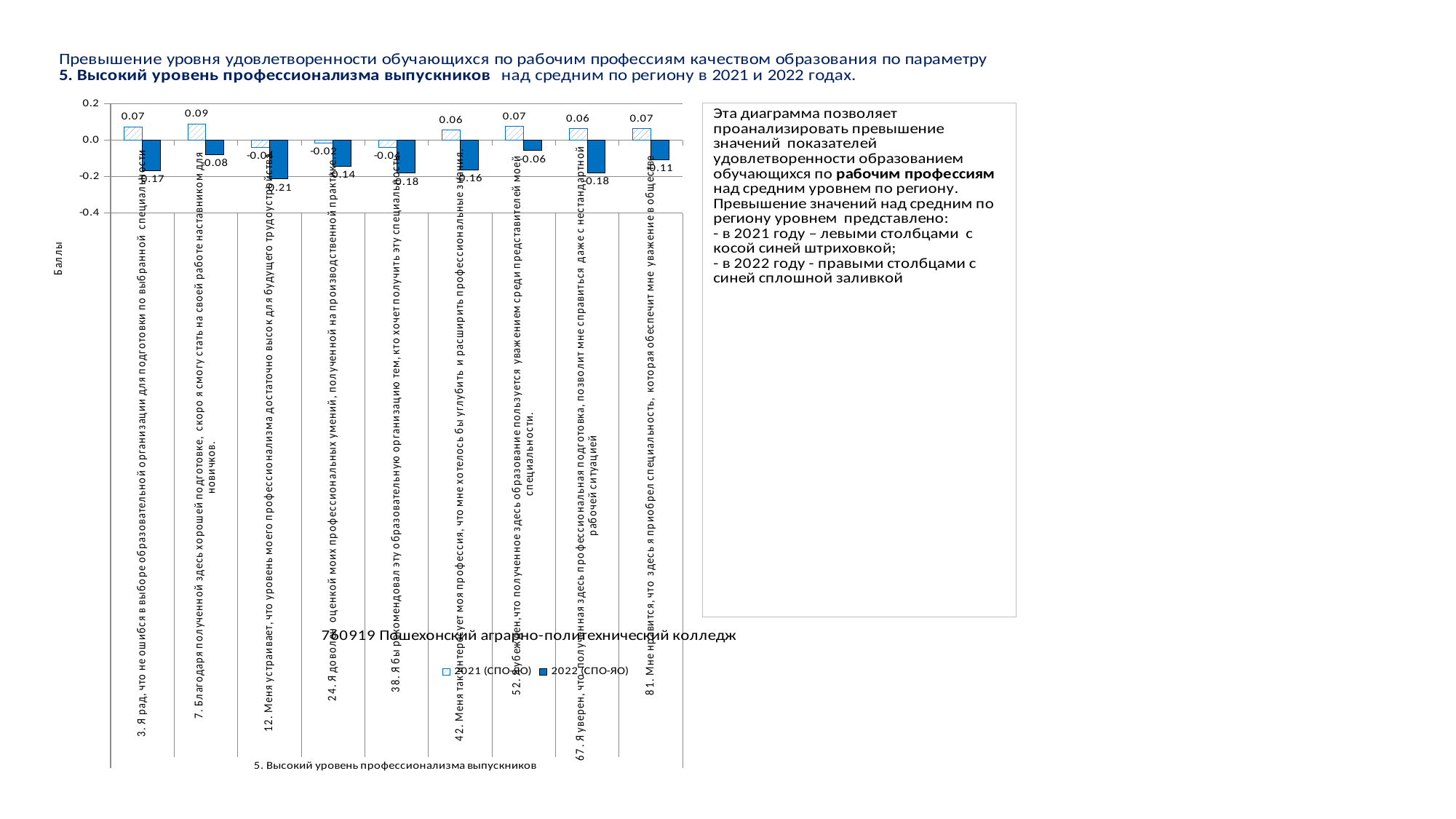
How many series does the chart legend list? 2 What is the 2022 (СПО-ЯО) value for statement 67 ("Я уверен, что полученная здесь профессиональная подготовка...")? -0.18 What is the 2022 (СПО-ЯО) value for statement 12 ("Меня устраивает, что уровень моего профессионализма...")? -0.21 What are the two entries in the chart legend? 2021 (СПО-ЯО) and 2022 (СПО-ЯО) How many statement categories are plotted on the x axis of the chart? 9 What is the difference between the 2021 and 2022 values for statement 3 ("Я рад, что не ошибся в выборе образовательной организации...")? 0.24 What is the 2021 (СПО-ЯО) value for statement 7 ("Благодаря полученной здесь хорошей подготовке...")? 0.09 Which statement has the highest 2022 (СПО-ЯО) value? 52. Я убежден, что полученное здесь образование пользуется уважением среди представителей моей специальности. Which statement has the highest 2021 (СПО-ЯО) value? 7. Благодаря полученной здесь хорошей подготовке, скоро я смогу стать на своей работе наставником для новичков. Which statement has the lowest 2022 (СПО-ЯО) value? 12. Меня устраивает, что уровень моего профессионализма достаточно высок для будущего трудоустройства Which is larger: the 2022 (СПО-ЯО) value for statement 7 or for statement 81? statement 7 What kind of chart is shown on the slide? bar chart